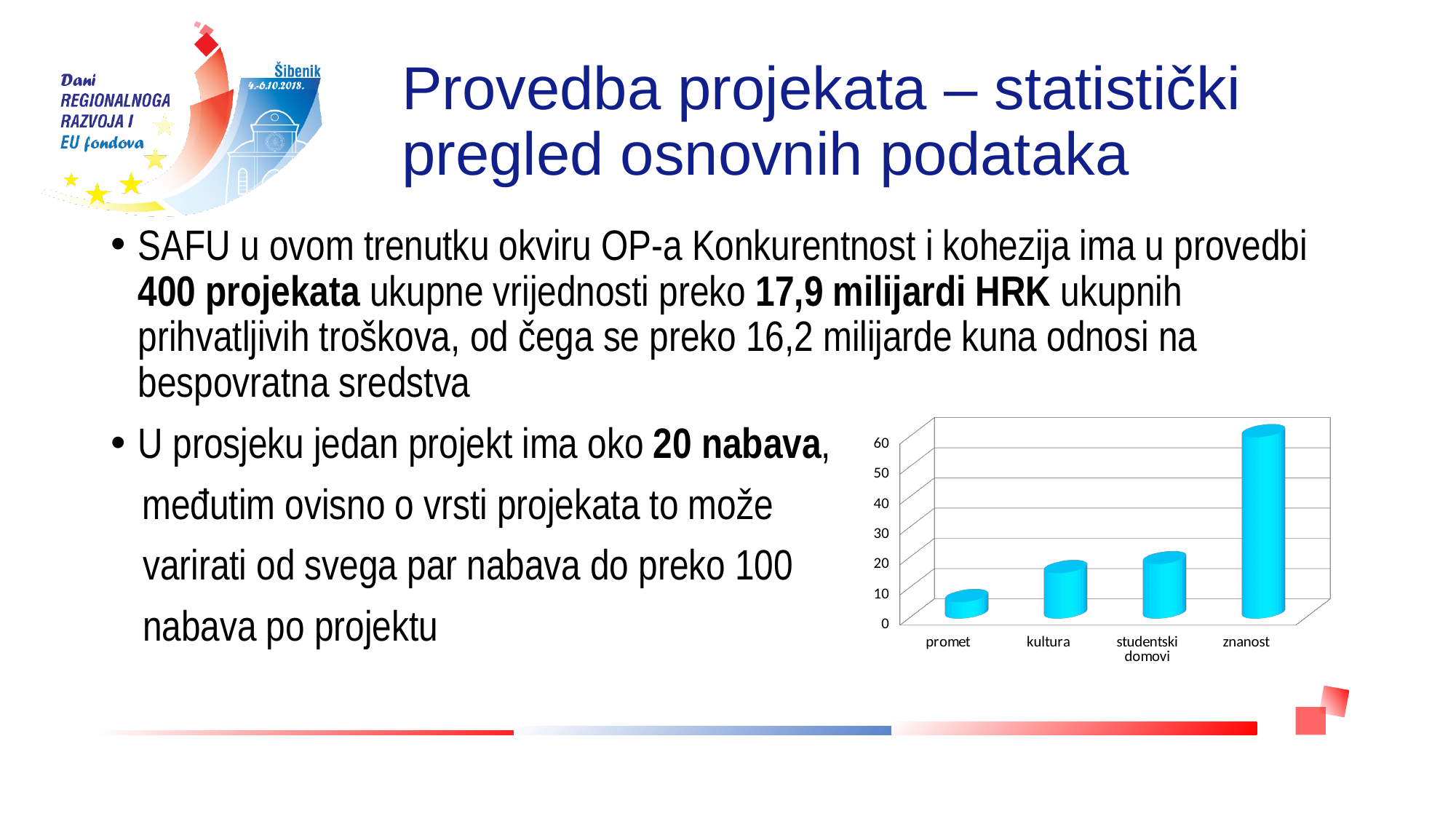
Is the value for promet greater or less than 10? less Which category has the lowest bar in the chart? promet How many categories are shown on the x axis of the chart? 4 Is the value for studentski domovi greater or less than 10? greater Do the bar values rise or fall from left to right along the x axis? rise Which is larger, the value for znanost or the value for studentski domovi? znanost Is the value for kultura greater or less than 10? greater Which is larger, the value for promet or the value for kultura? kultura What kind of chart is shown on the slide? bar chart Which category has the highest bar in the chart? znanost